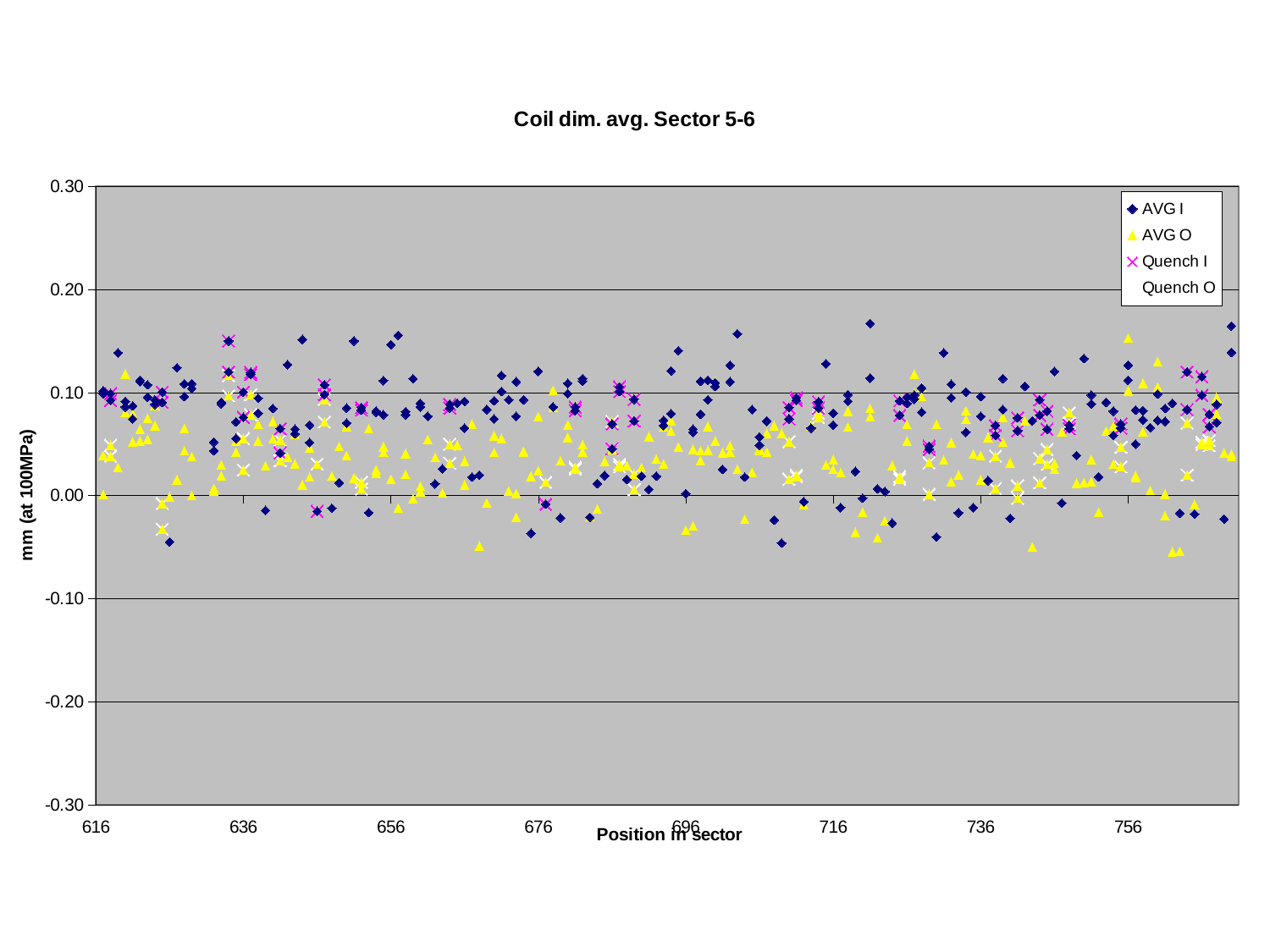
How many series does the legend list? 4 Is the highest AVG I value greater or less than 0.10? greater What is the title of the chart? Coil dim. avg. Sector 5-6 Are the plotted values for all series greater or less than 0.20? less Is the lowest AVG O value greater or less than 0.00? less Which series is plotted with yellow triangles? AVG O What kind of chart is shown on the slide? scatter chart